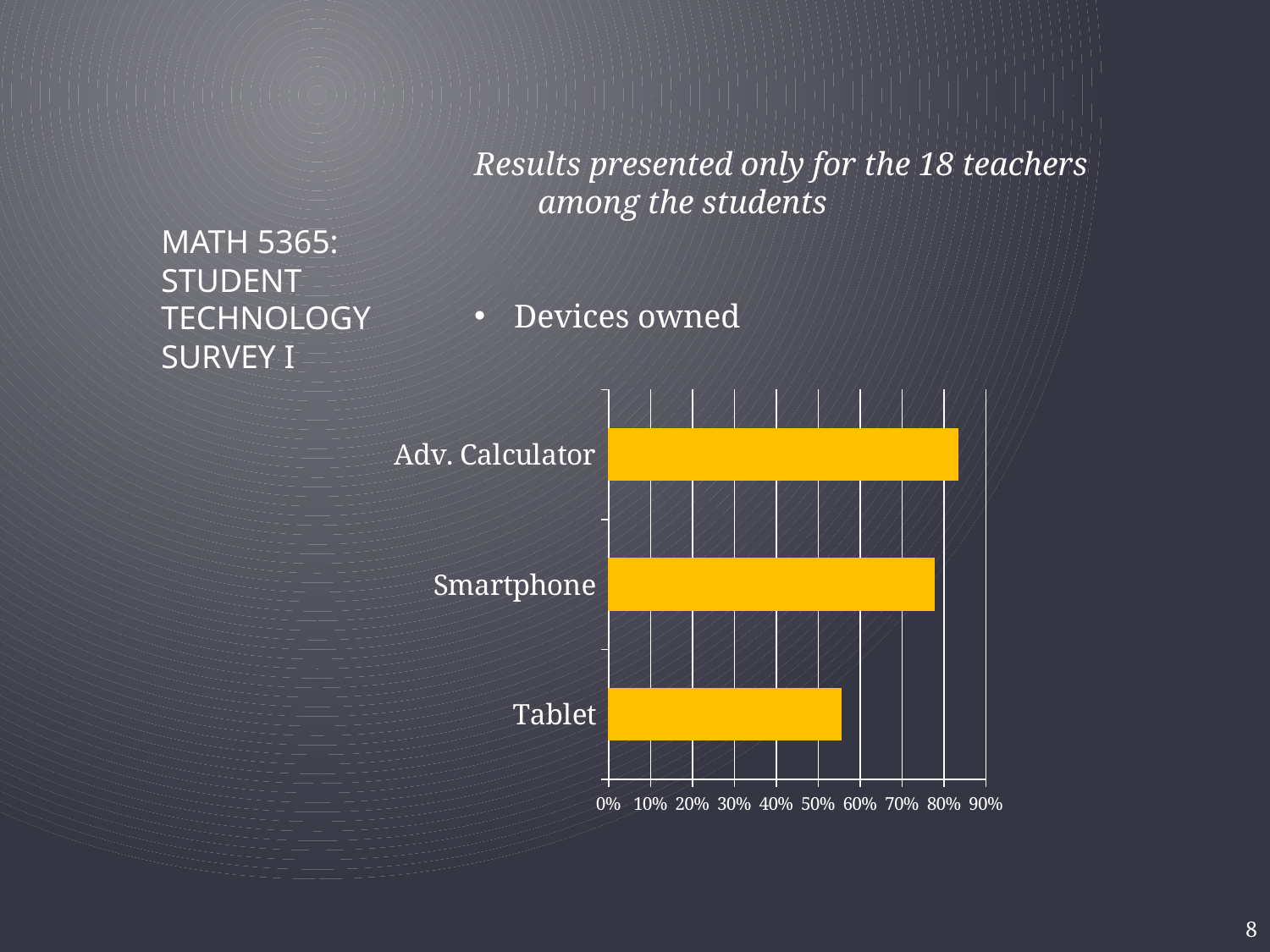
Is the value for Smartphone greater or less than 70%? greater Is the value for Adv. Calculator greater or less than 80%? greater How many device categories are shown in the chart? 3 Which is larger, the value for Adv. Calculator or the value for Smartphone? Adv. Calculator Which device category has the lowest percentage in the chart? Tablet What is the highest percentage tick shown on the chart's horizontal axis? 90% What kind of chart is shown on the slide? bar chart Which device category has the highest percentage in the chart? Adv. Calculator Is the value for Tablet greater or less than 50%? greater Which is larger, the value for Smartphone or the value for Tablet? Smartphone